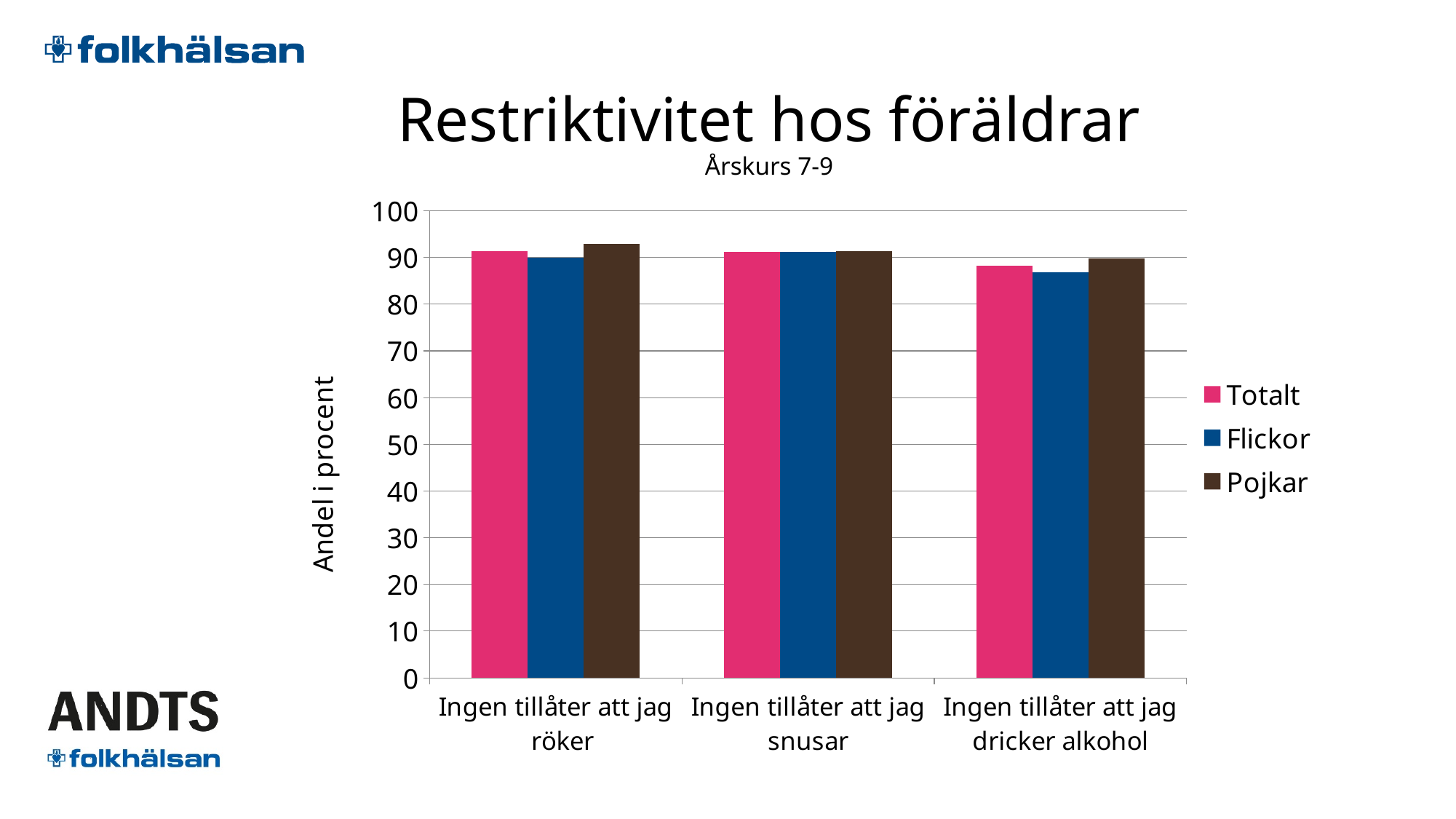
What is the title of the chart? Restriktivitet hos föräldrar What kind of chart is shown on the slide? bar chart For the Flickor series, which category has the lowest value? Ingen tillåter att jag dricker alkohol Is the value for Flickor in 'Ingen tillåter att jag dricker alkohol' greater or less than 90? less What is the label on the vertical axis? Andel i procent For the Pojkar series, which category has the highest value? Ingen tillåter att jag röker In 'Ingen tillåter att jag dricker alkohol', which is larger, Flickor or Pojkar? Pojkar How many series does the legend list? 3 How many categories are shown on the x axis? 3 Is the value for Totalt in 'Ingen tillåter att jag snusar' greater or less than 80? greater In 'Ingen tillåter att jag röker', which is larger, Flickor or Pojkar? Pojkar Is the value for Pojkar in 'Ingen tillåter att jag röker' greater or less than 90? greater